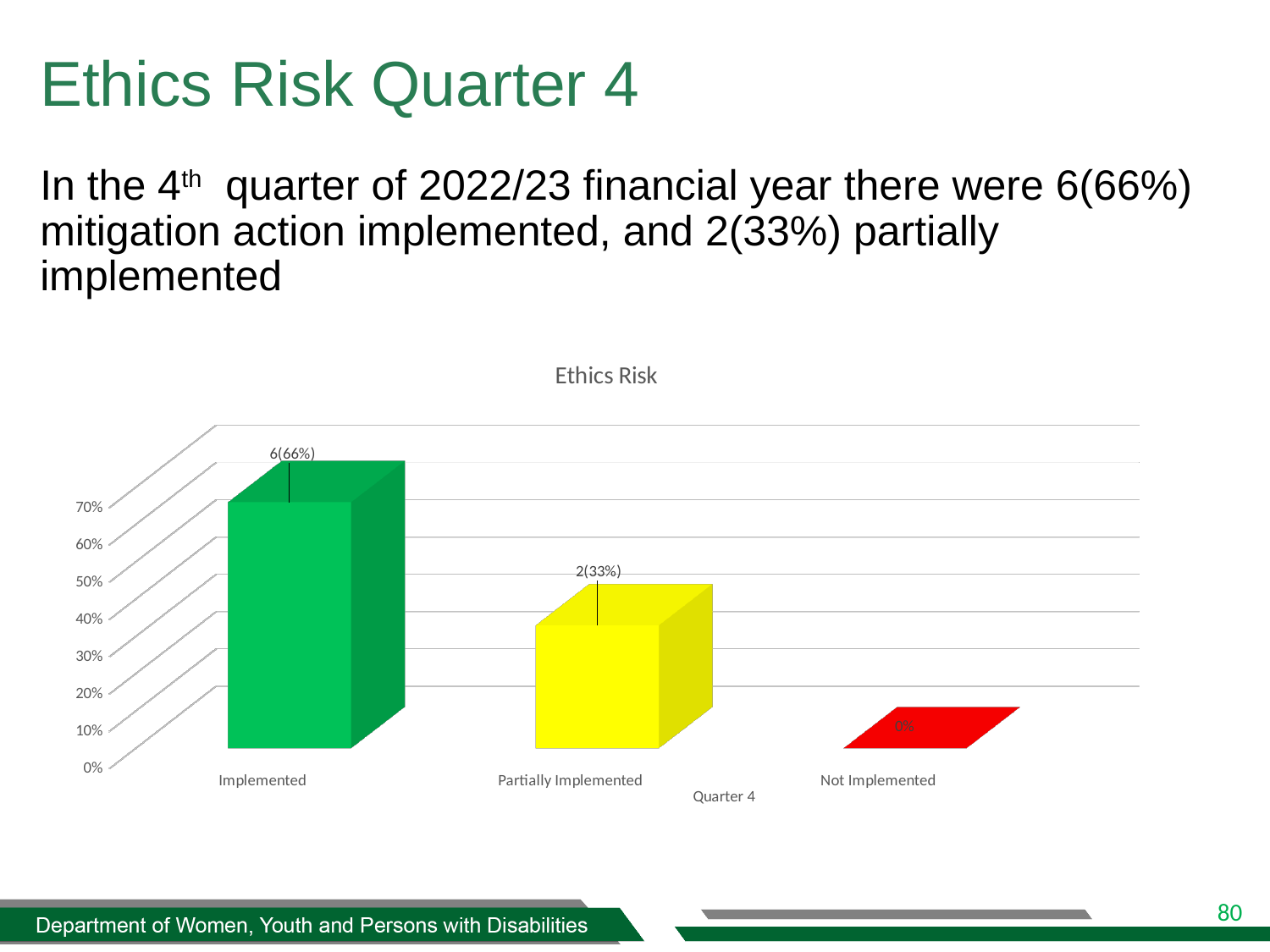
What is the data label shown for the Partially Implemented bar? 2(33%) How many categories are shown on the x axis? 3 Which category has the lowest value? Not Implemented What is the title of the chart? Ethics Risk Which category has the highest value? Implemented What is the data label shown for the Implemented bar? 6(66%) What is the x-axis label shown below the categories? Quarter 4 What kind of chart is shown? bar chart What is the data label shown for the Not Implemented category? 0% Is the value for Implemented greater or less than 50%? greater Which is larger, the value for Implemented or the value for Partially Implemented? Implemented Is the value for Partially Implemented greater or less than 50%? less